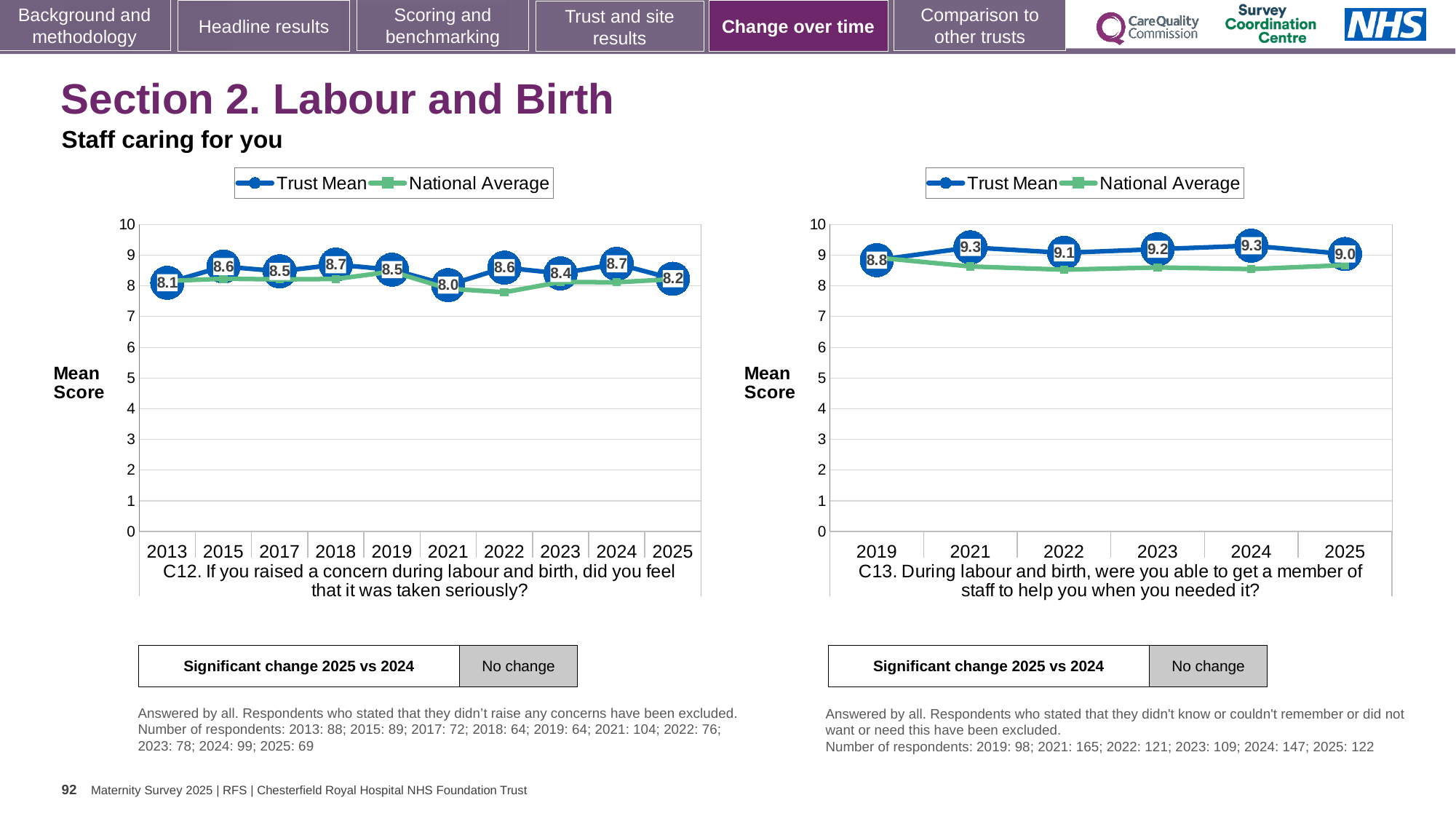
In the C12 chart on the left, which year has the lowest Trust Mean? 2021 In the C13 chart on the right, which year has the lowest Trust Mean? 2019 How many years are plotted on the x axis of the C12 chart on the left? 10 In the C12 chart on the left, what is the Trust Mean for 2025? 8.2 How many series does the legend of the C13 chart on the right list? 2 In the C13 chart on the right, what is the Trust Mean for 2019? 8.8 In the C13 chart on the right, what is the Trust Mean for 2025? 9.0 In the C12 chart on the left, what is the difference between the Trust Mean for 2024 and for 2025? 0.5 In the C12 chart on the left, what is the Trust Mean for 2021? 8.0 What kind of chart is the C13 chart on the right? Line chart In the C13 chart on the right, which year has the larger Trust Mean, 2021 or 2025? 2021